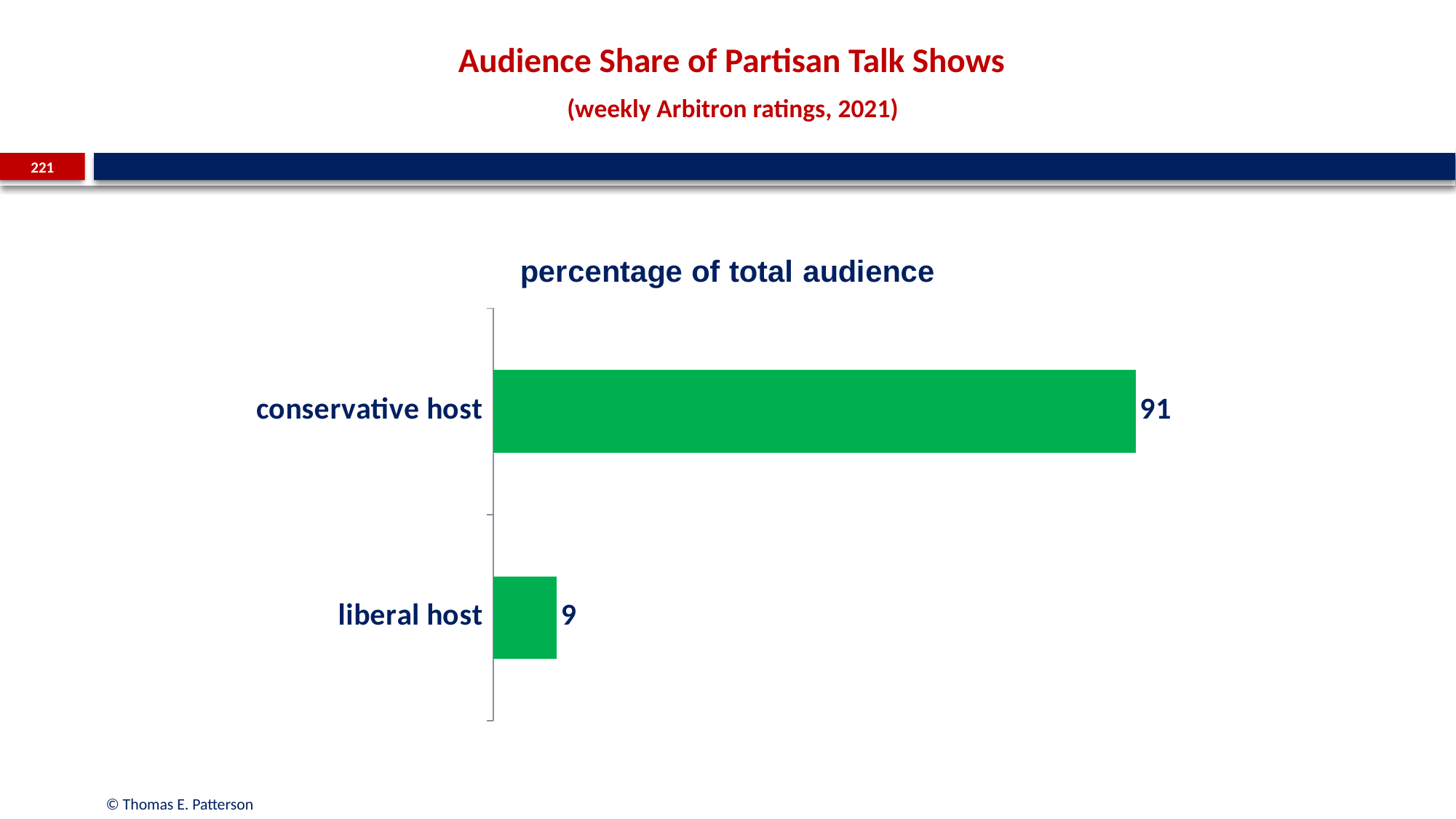
Which is larger, the value for conservative host or the value for liberal host? conservative host What is the difference between the values for conservative host and liberal host? 82 What is the title of the chart? percentage of total audience What is the value for liberal host? 9 How many categories are shown in the chart? 2 Which category has the highest value? conservative host Which category has the lowest value? liberal host What is the total of the two values shown in the chart? 100 What kind of chart is shown on the slide? bar chart What is the value for conservative host? 91 What colour are the bars in the chart? green